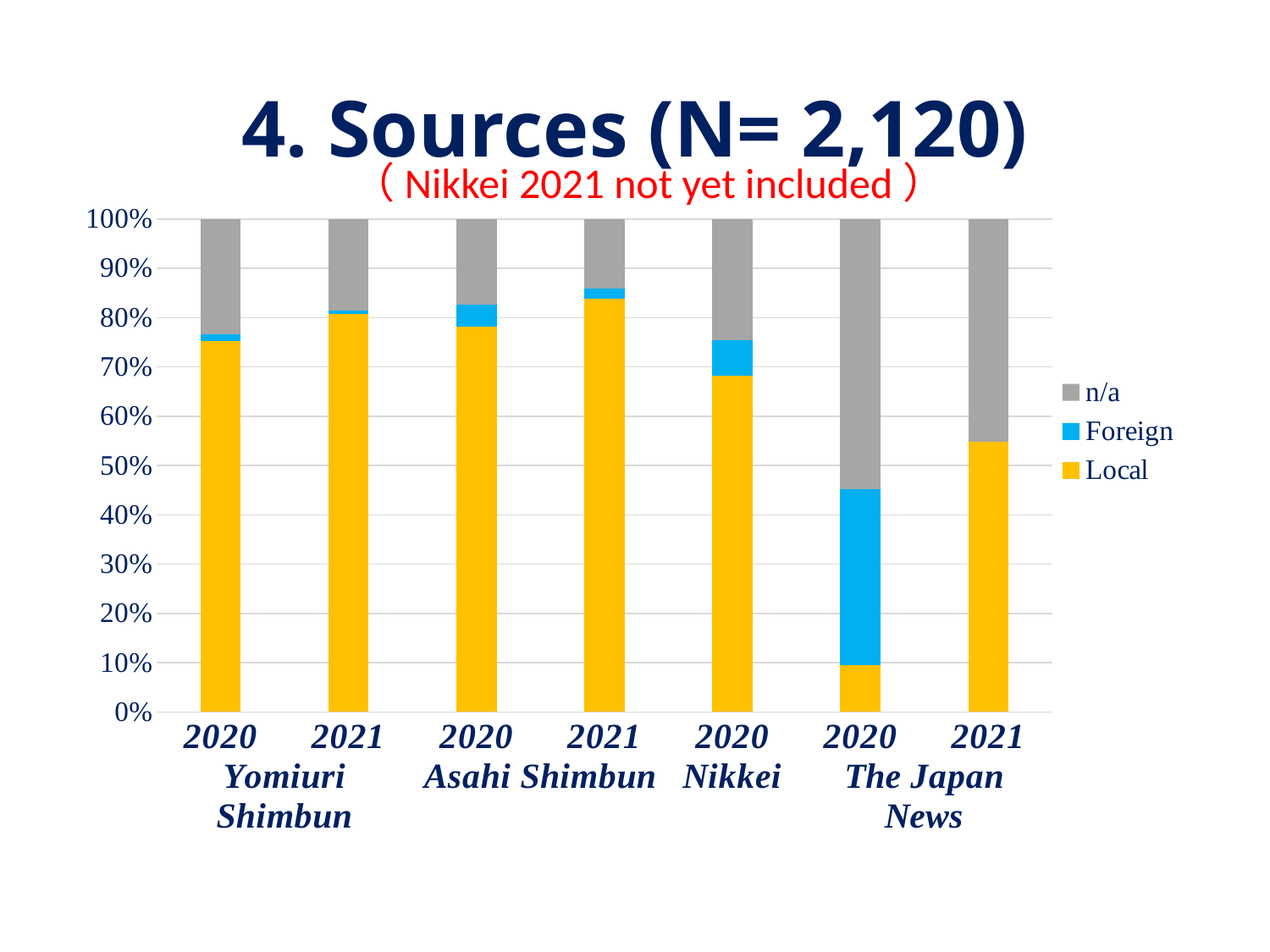
How many series does the legend list? 3 Is the Local share for Nikkei 2020 greater or less than 60%? greater Which has the larger Foreign share, Asahi Shimbun 2020 or Nikkei 2020? Nikkei 2020 What are the three entries in the chart's legend? n/a, Foreign, Local Which bar has the largest Foreign share? The Japan News 2020 Which bar has the largest n/a share? The Japan News 2020 How many bars are plotted in the chart? 7 Which has the larger Local share, Yomiuri Shimbun 2020 or Yomiuri Shimbun 2021? Yomiuri Shimbun 2021 Is the Local share for The Japan News 2020 greater or less than 20%? less Is the Foreign share for The Japan News 2020 greater or less than 30%? greater Which bar has the smallest Local share? The Japan News 2020 What kind of chart is shown on the slide? Stacked bar chart